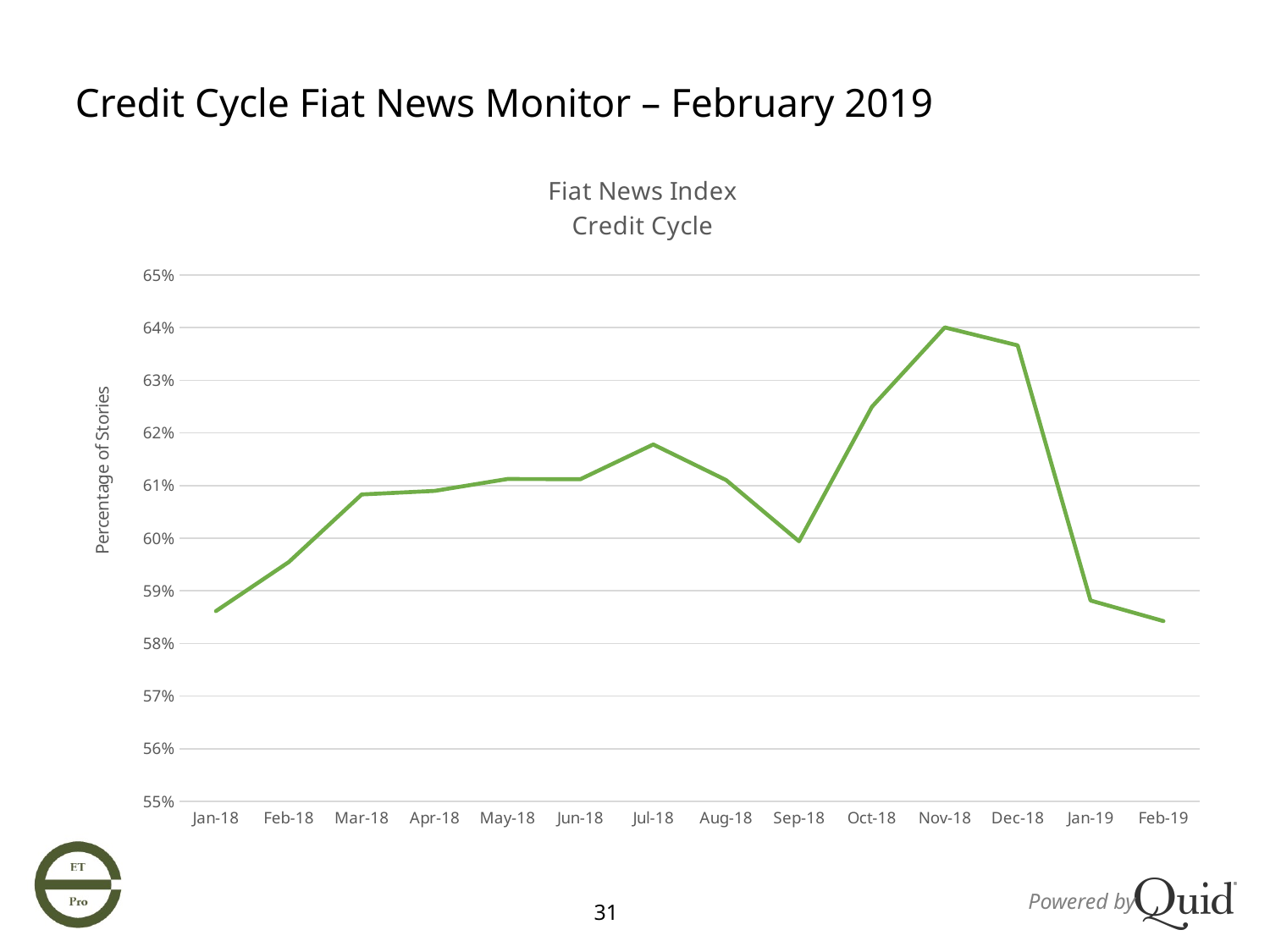
Do the values rise or fall from Dec-18 to Feb-19? fall Is the value for Dec-18 greater or less than 63%? greater What is the label on the y axis? Percentage of Stories What kind of chart is shown on the slide? line chart How many months are plotted along the x axis? 14 Is the value for Oct-18 greater or less than 62%? greater Which is larger, the value for Jul-18 or the value for Sep-18? Jul-18 Which is larger, the value for Nov-18 or the value for Feb-19? Nov-18 Is the value for Mar-18 greater or less than 60%? greater Do the values rise or fall from Sep-18 to Nov-18? rise Which month has the highest percentage of stories? Nov-18